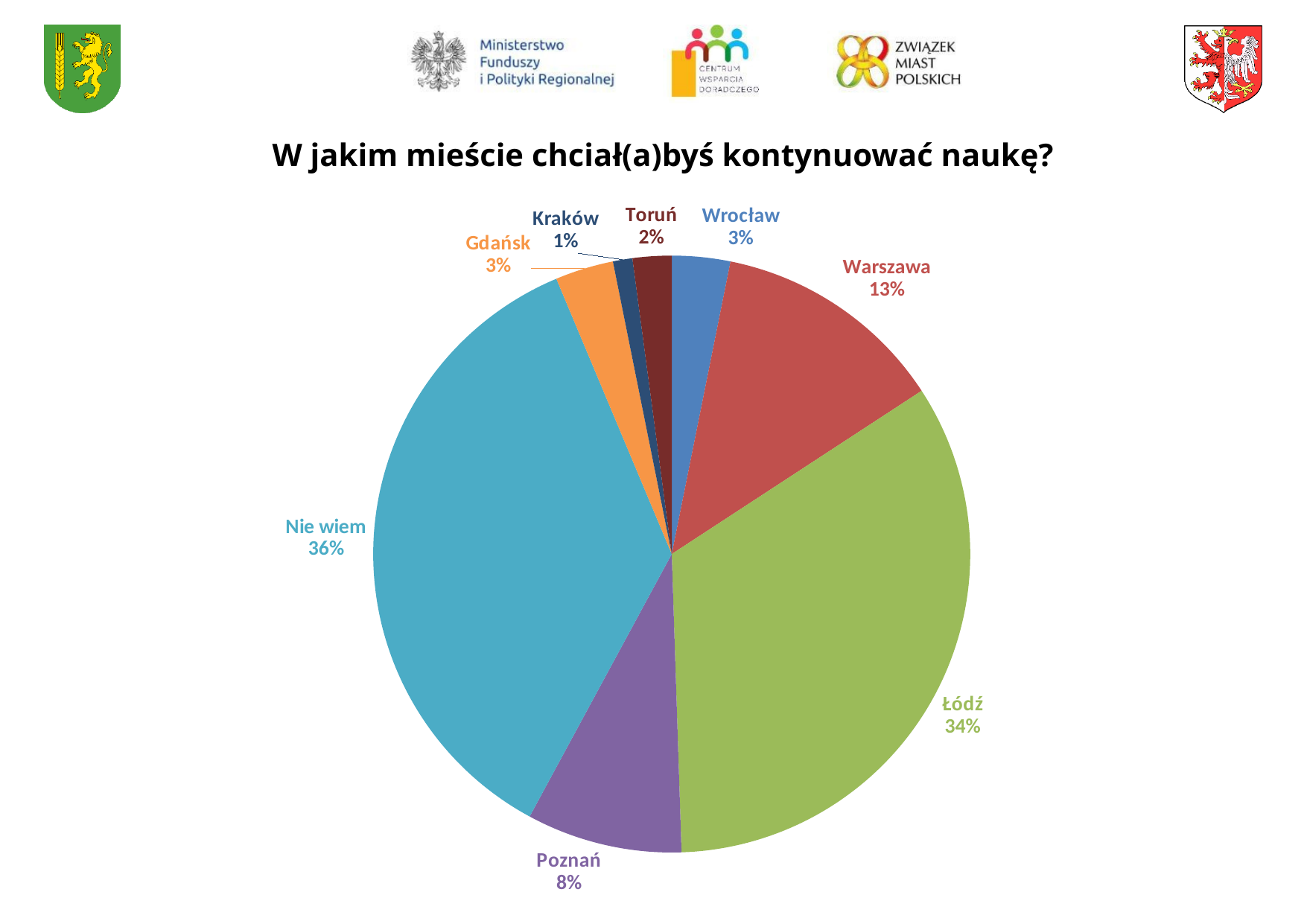
How many categories are shown in the pie chart? 8 Which category has the smallest slice of the pie? Kraków What is the value for Warszawa? 13% What is the difference between the values for Warszawa and Poznań? 5% What is the value for Poznań? 8% What is the difference between the values for Nie wiem and Łódź? 2% Which is larger, the value for Warszawa or the value for Poznań? Warszawa What share of the pie does Łódź have? 34% What is the value for Toruń? 2% Which category has the largest slice of the pie? Nie wiem What type of chart is shown on the slide? pie chart What is the title of the chart? W jakim mieście chciał(a)byś kontynuować naukę?